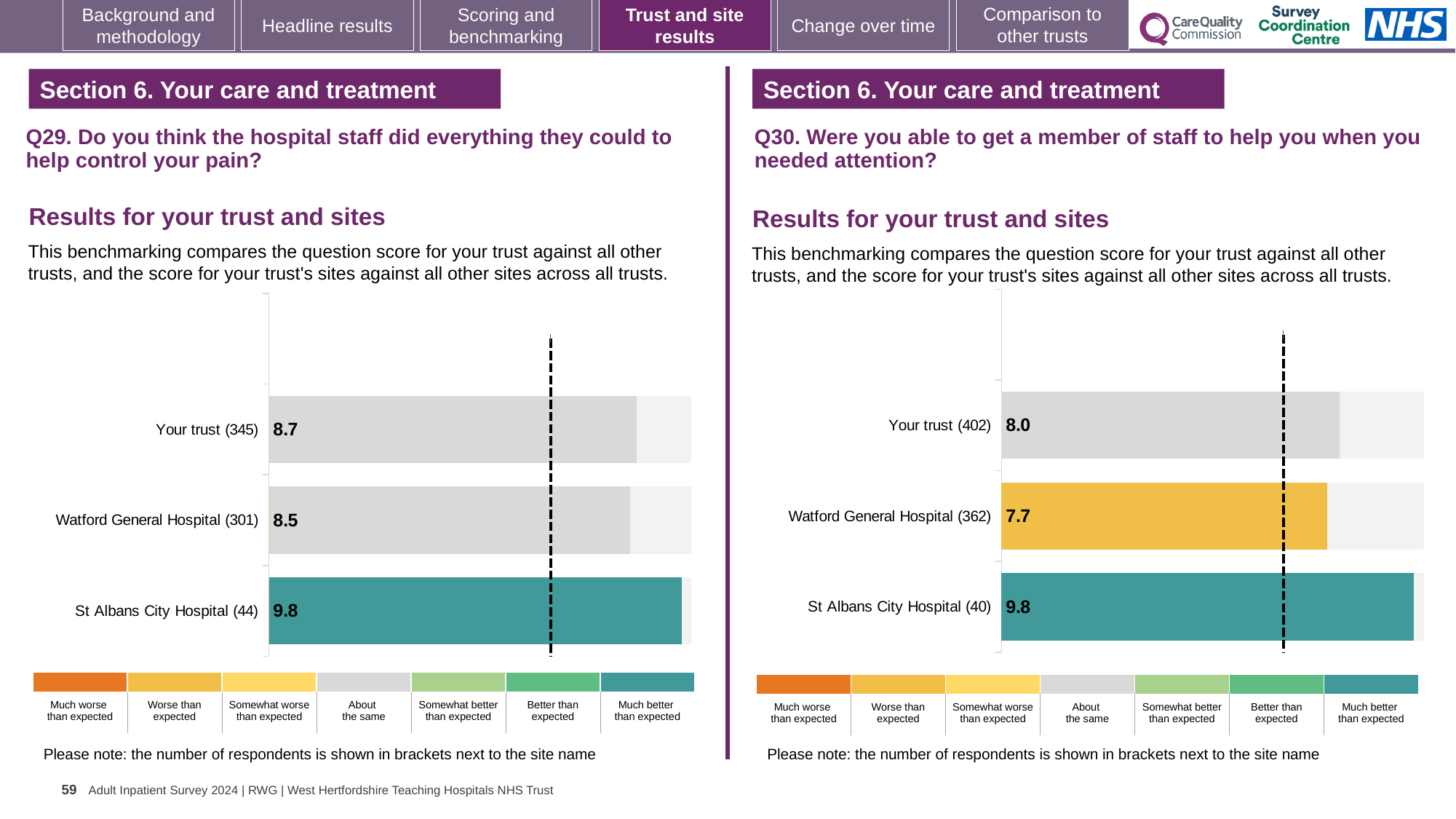
On the Q30 chart (right), what is the score for Your trust (402)? 8.0 On the Q30 chart (right), which site or trust has the lowest score? Watford General Hospital (362) On the Q29 chart (left), what is the score for Watford General Hospital (301)? 8.5 On the Q30 chart (right), what is the score for Watford General Hospital (362)? 7.7 On the Q30 chart (right), what is the difference between the scores for St Albans City Hospital (40) and Your trust (402)? 1.8 On the Q29 chart (left), what is the difference between the scores for St Albans City Hospital (44) and Watford General Hospital (301)? 1.3 What kind of chart is used on the Q30 chart (right)? Bar chart On the Q30 chart (right), which benchmark category does the colour of the Watford General Hospital (362) bar correspond to in the legend? Worse than expected On the Q29 chart (left), how many bars are plotted? 3 On the Q30 chart (right), which is larger: the score for Your trust (402) or for St Albans City Hospital (40)? St Albans City Hospital (40) On the Q29 chart (left), which site or trust has the highest score? St Albans City Hospital (44) On the Q29 chart (left), what is the score for Your trust (345)? 8.7